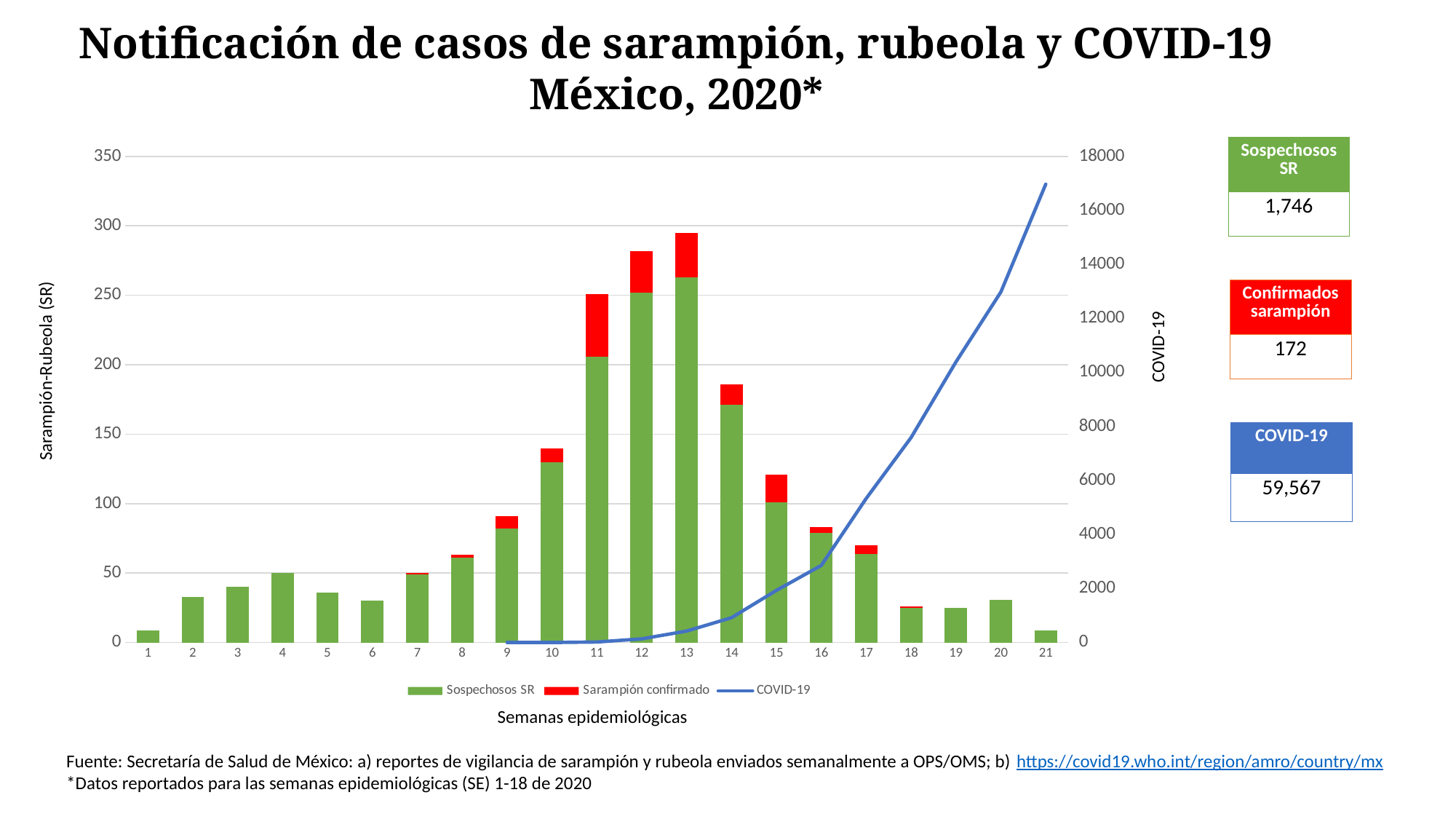
How many epidemiological weeks are shown on the x axis? 21 How many series does the legend list? 3 Is the COVID-19 value at week 21 greater or less than 16000? greater Is the stacked bar for week 1 greater or less than 50? less What total is shown in the Confirmados sarampión box? 172 What kind of chart is shown on the slide? A combination of a stacked bar chart and a line chart What is the label of the left vertical axis? Sarampión-Rubeola (SR) Which epidemiological week has the tallest stacked bar? 13 Is the total stacked bar for week 12 greater or less than 250? greater Does the COVID-19 line rise or fall from week 9 to week 21? Rises Which stacked bar is taller, week 11 or week 14? Week 11 What total is shown in the Sospechosos SR box on the right of the slide? 1,746